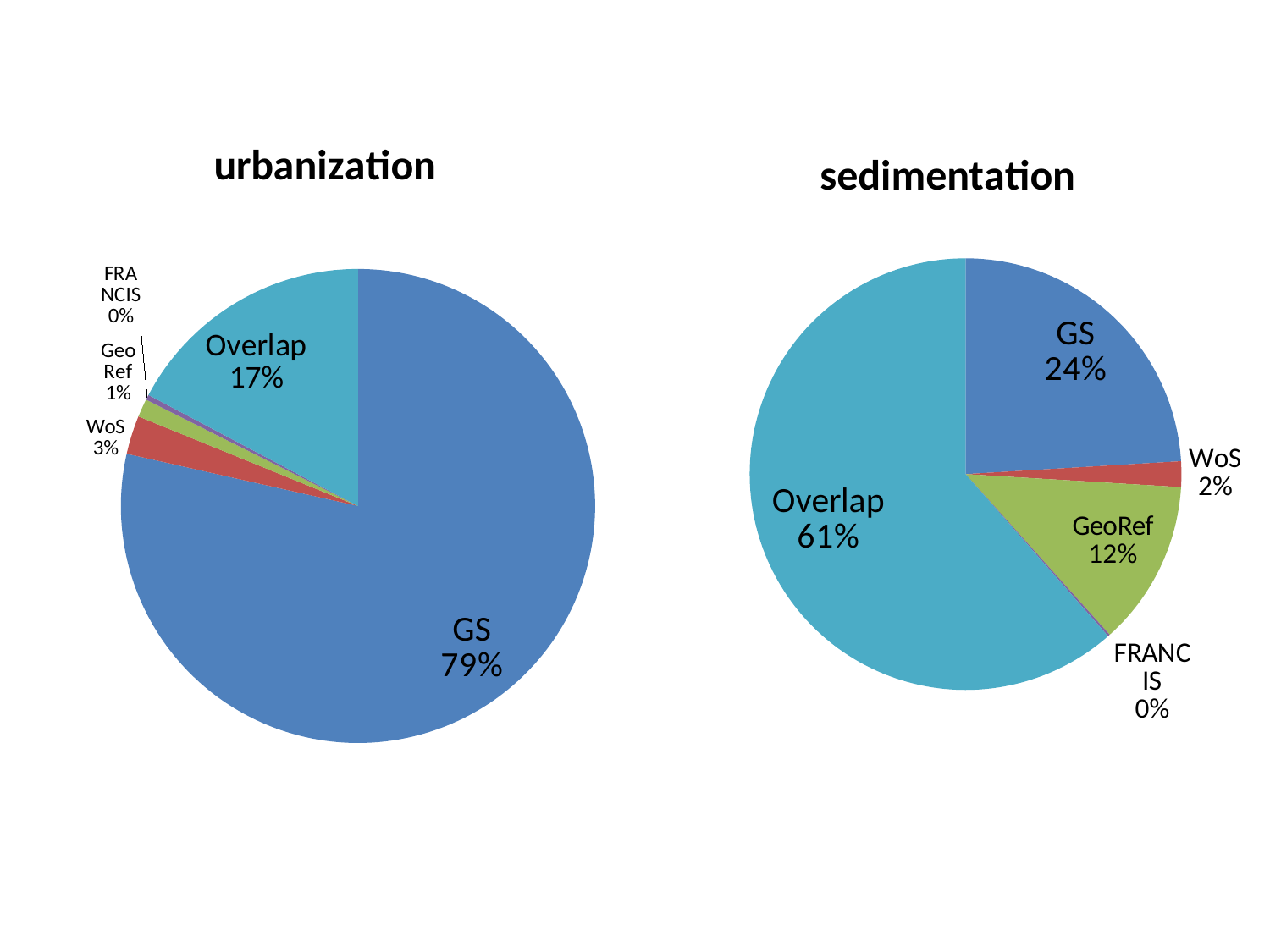
In the sedimentation chart, which category has the smallest slice? FRANCIS In the sedimentation chart, what share does Overlap have? 61% What is the difference between the GS share in the urbanization chart and the GS share in the sedimentation chart? 55% In the urbanization chart, what share does WoS have? 3% In the urbanization chart, what share does GS have? 79% In the sedimentation chart, which category has the largest slice? Overlap In the urbanization chart, which category has the largest slice? GS What type of chart is the urbanization chart? Pie chart In the sedimentation chart, which is larger, GeoRef or WoS? GeoRef